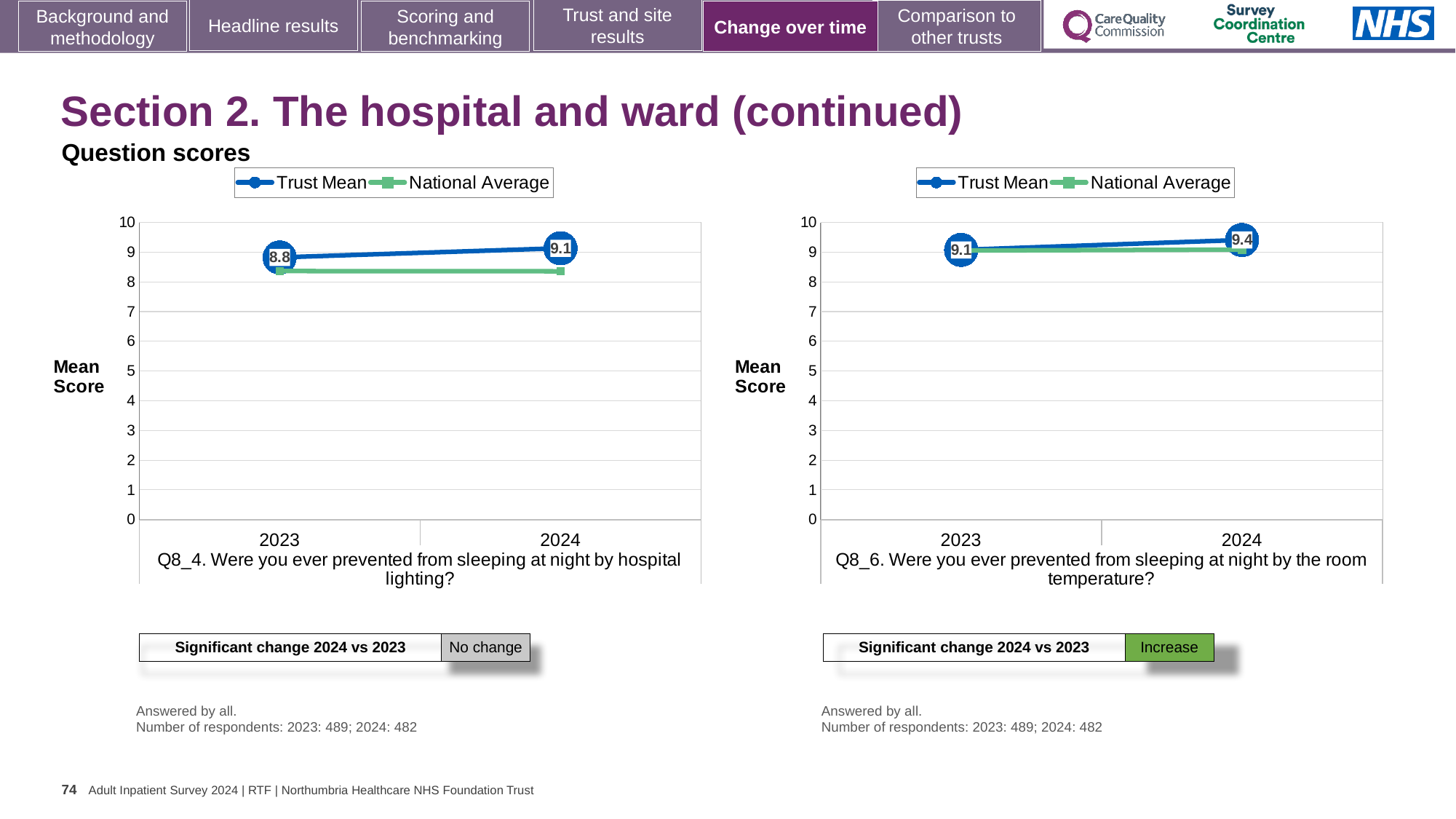
What kind of chart is the Q8_4 chart on the left? line chart In the Q8_6 chart (right), what is the Trust Mean score for 2023? 9.1 In the Q8_4 chart (left), what is the Trust Mean score for 2024? 9.1 In the Q8_6 chart (right), does the Trust Mean rise or fall from 2023 to 2024? rise In the Q8_4 chart (left), is the National Average value for 2024 greater or less than 9? less In the Q8_6 chart (right), what is the Trust Mean score for 2024? 9.4 What significant change result is shown below the Q8_6 chart (right) for 2024 vs 2023? Increase In the Q8_4 chart (left), which series has the higher value in 2024, Trust Mean or National Average? Trust Mean In the Q8_4 chart (left), what is the Trust Mean score for 2023? 8.8 How many series does the legend of the Q8_6 chart (right) list? 2 How many years are shown on the x axis of the Q8_4 chart (left)? 2 In the Q8_4 chart (left), by how much did the Trust Mean change from 2023 to 2024? 0.3